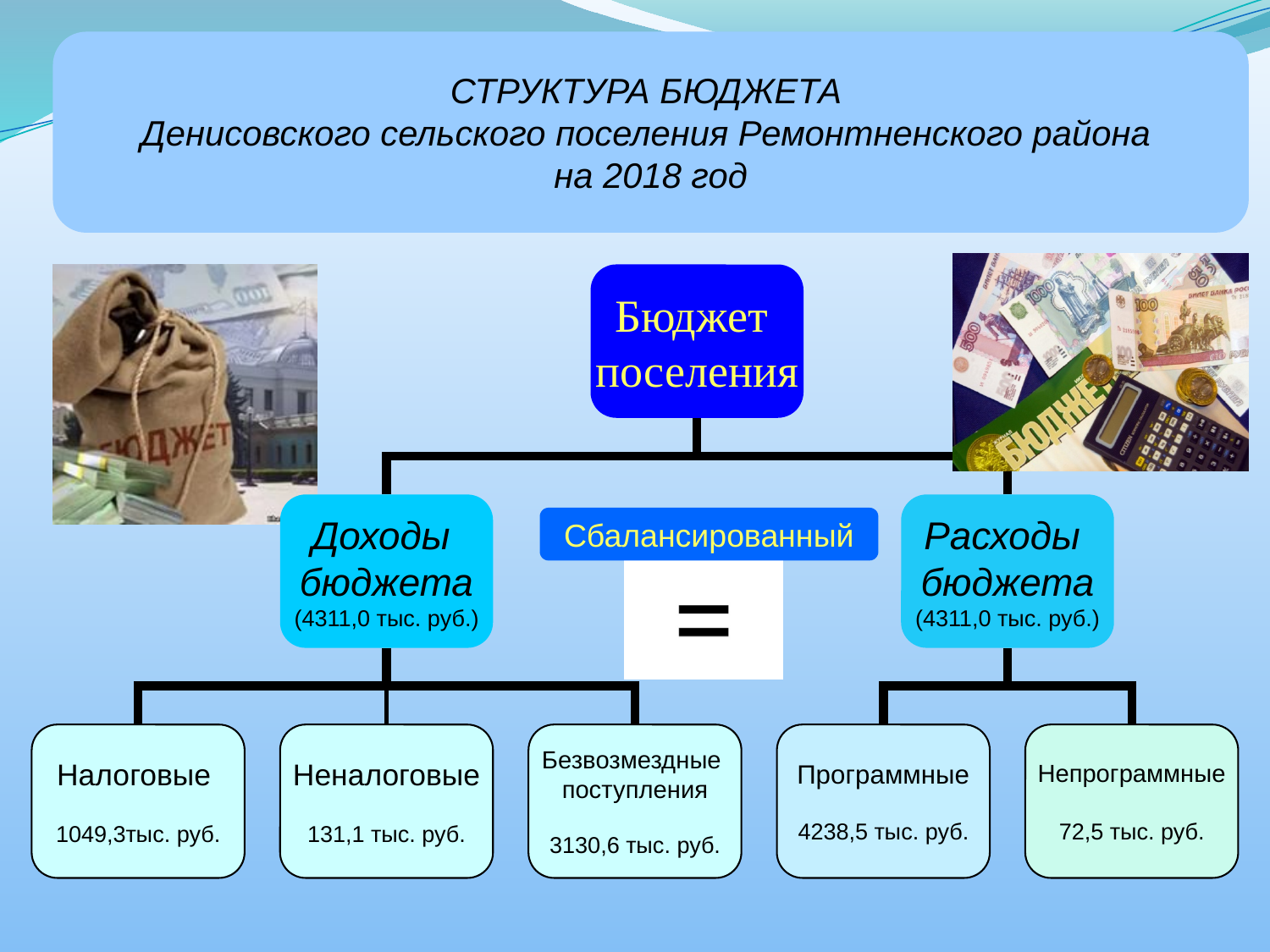
Which is larger, Программные or Непрограммные expenditures? Программные What is the value shown for Программные expenditures? 4238,5 тыс. руб. Which of the three revenue components has the smallest value? Неналоговые What is the value shown for Непрограммные expenditures? 72,5 тыс. руб. What is the value shown for Безвозмездные поступления? 3130,6 тыс. руб. What is the difference between Программные and Непрограммные expenditures? 4166,0 тыс. руб. What total is shown for Доходы бюджета (budget revenues)? 4311,0 тыс. руб. How many revenue components are shown under Доходы бюджета? 3 What is the value shown for Налоговые (tax revenues)? 1049,3 тыс. руб. What is the value shown for Неналоговые (non-tax revenues)? 131,1 тыс. руб. What word is shown in the box between Доходы бюджета and Расходы бюджета? Сбалансированный Which of the three revenue components (Налоговые, Неналоговые, Безвозмездные поступления) has the largest value? Безвозмездные поступления